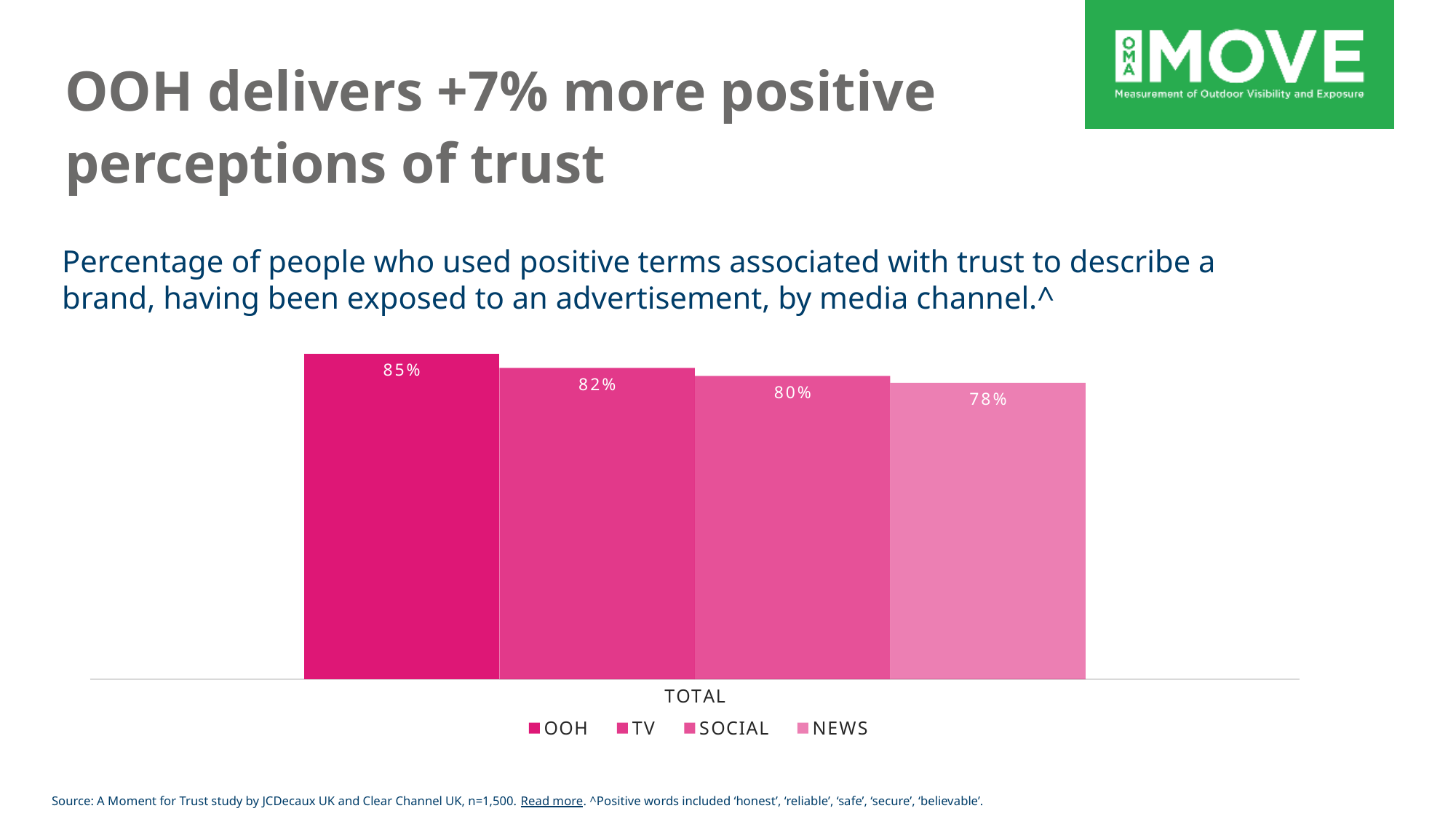
What is the value for SOCIAL? 80% What is the value for TV? 82% Which media channel has the highest value? OOH What is the difference between the values for OOH and NEWS? 7% What is the value for NEWS? 78% What is the value for OOH? 85% Which media channel has the lowest value? NEWS Which is larger, the value for TV or the value for NEWS? TV How many series does the legend list? 4 What kind of chart is shown on the slide? Bar chart What is the category label shown on the x axis? TOTAL What is the difference between the values for TV and SOCIAL? 2%